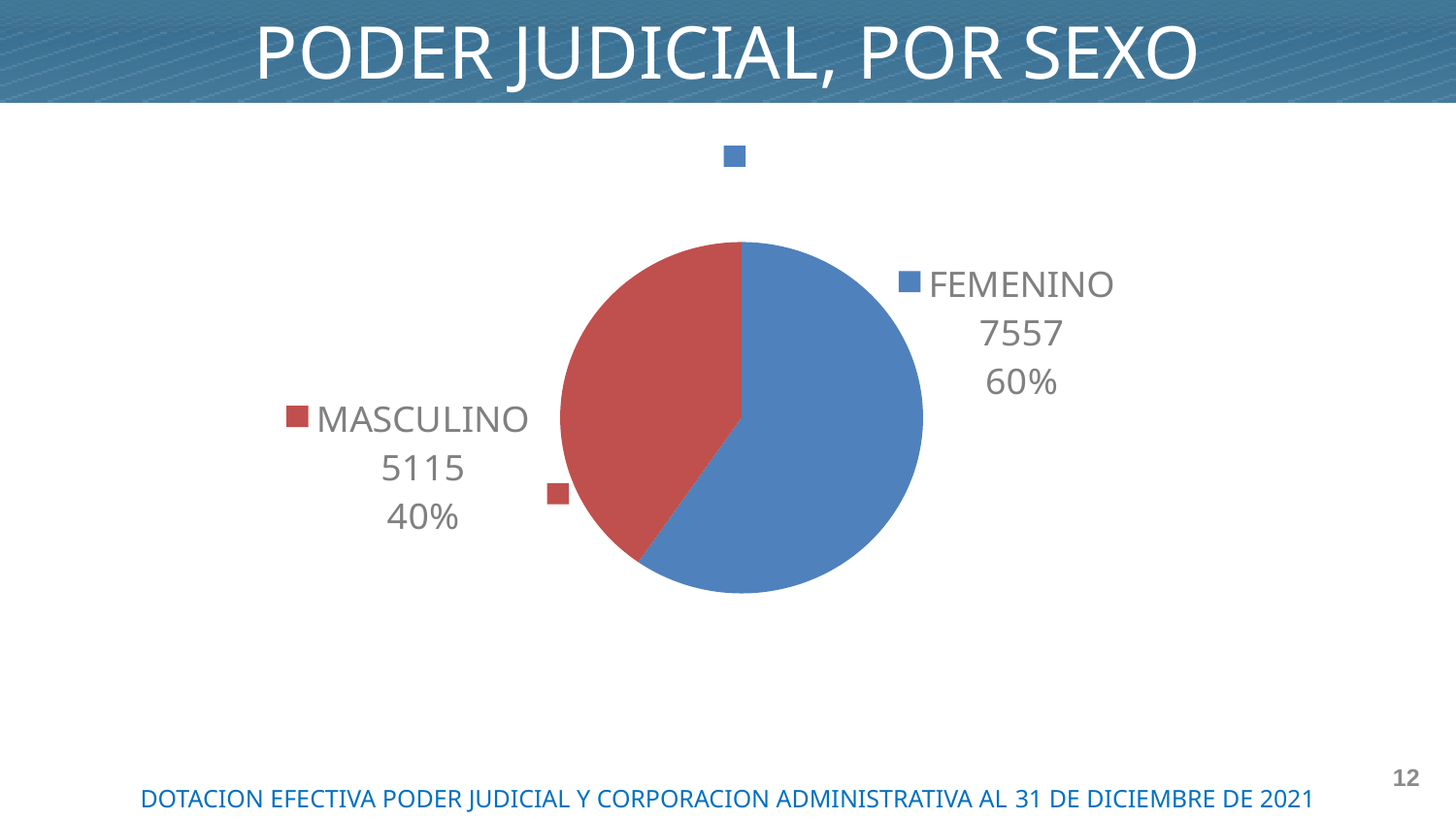
Which is larger, the value for FEMENINO or the value for MASCULINO? FEMENINO What percentage share of the pie does MASCULINO have? 40% What is the value for FEMENINO? 7557 What percentage share of the pie does FEMENINO have? 60% What is the value for MASCULINO? 5115 How many categories are shown in the pie chart? 2 What is the difference between the FEMENINO and MASCULINO values? 2442 What is the total of the two values shown in the pie chart? 12672 Which category has the smallest slice of the pie? MASCULINO What kind of chart is shown on the slide? pie chart Which category has the largest slice of the pie? FEMENINO What colour is the FEMENINO slice of the pie? blue